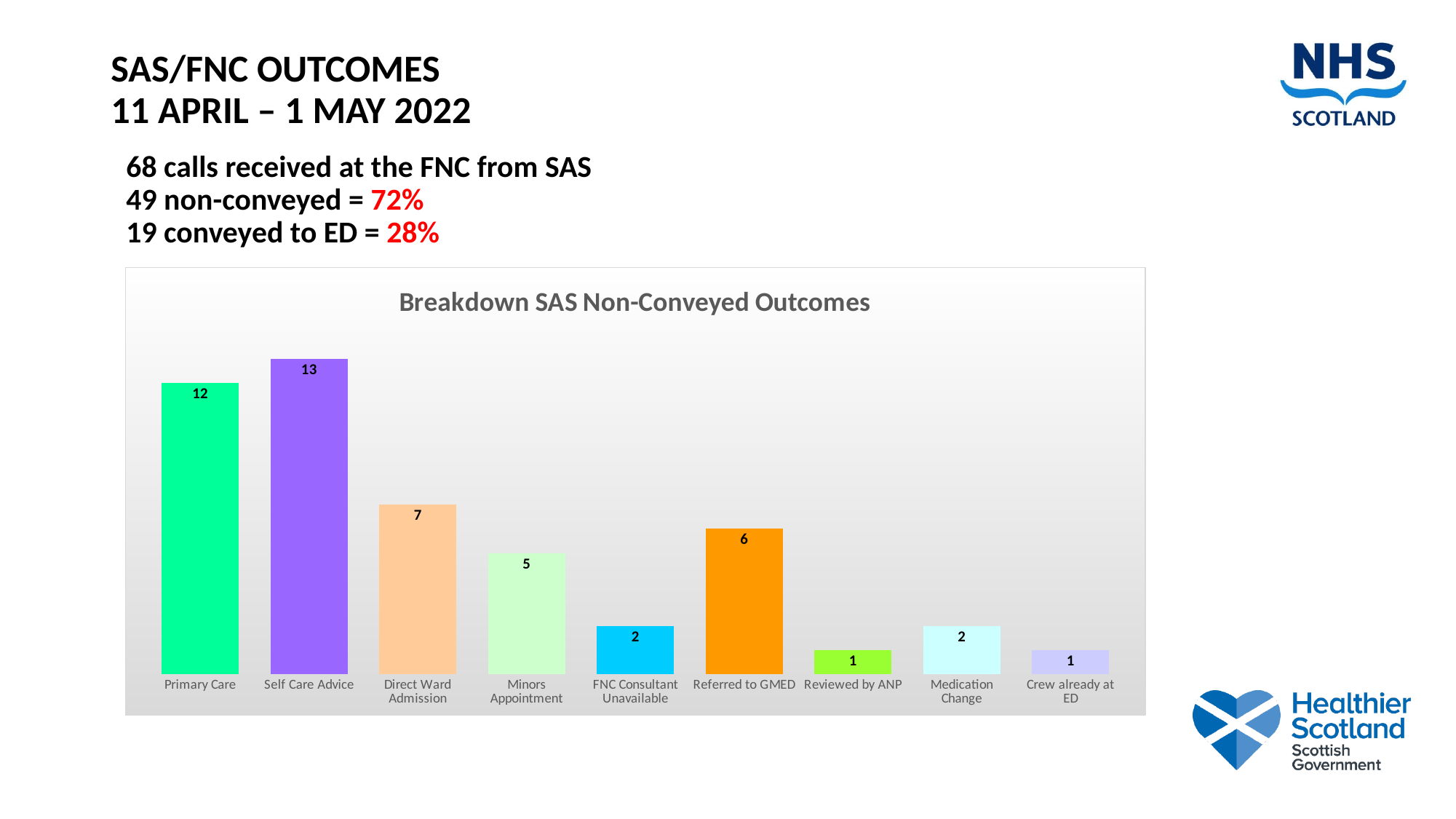
How many categories are shown on the x axis? 9 Which category has the highest value? Self Care Advice What is the title of the chart? Breakdown SAS Non-Conveyed Outcomes What kind of chart is this? bar chart What is the value for Self Care Advice? 13 What is the value for Reviewed by ANP? 1 What is the difference between the values for Self Care Advice and Primary Care? 1 What is the difference between the values for Direct Ward Admission and Minors Appointment? 2 What is the value for Medication Change? 2 What is the value for Direct Ward Admission? 7 What is the value for Referred to GMED? 6 Which is larger, the value for Minors Appointment or the value for Referred to GMED? Referred to GMED